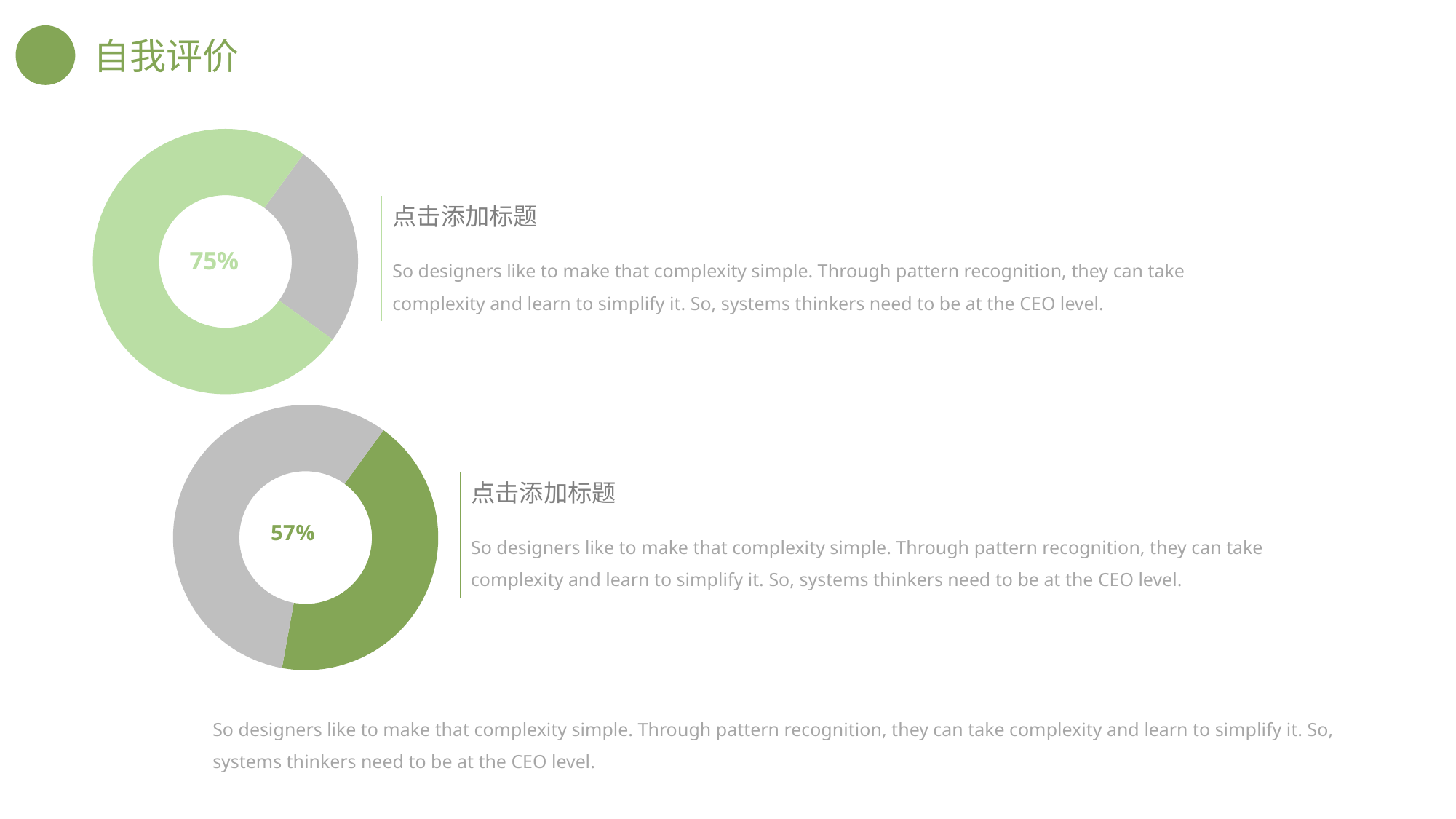
What colour is the filled segment of the top donut chart? Light green Which donut chart shows the higher percentage, the top one or the bottom one? The top one What is the difference between the percentage in the top donut chart and the percentage in the bottom donut chart? 18 percentage points Is the value shown in the bottom donut chart greater or less than 50%? greater What percentage is shown in the centre of the bottom donut chart? 57% What percentage is shown in the centre of the top donut chart? 75% What kind of chart is used on this slide? Donut (pie) chart Which donut chart shows the lowest percentage? The bottom one (57%) How many donut charts are on the slide? 2 Is the value shown in the top donut chart greater or less than 50%? greater What is the title of the slide containing the two donut charts? 自我评价